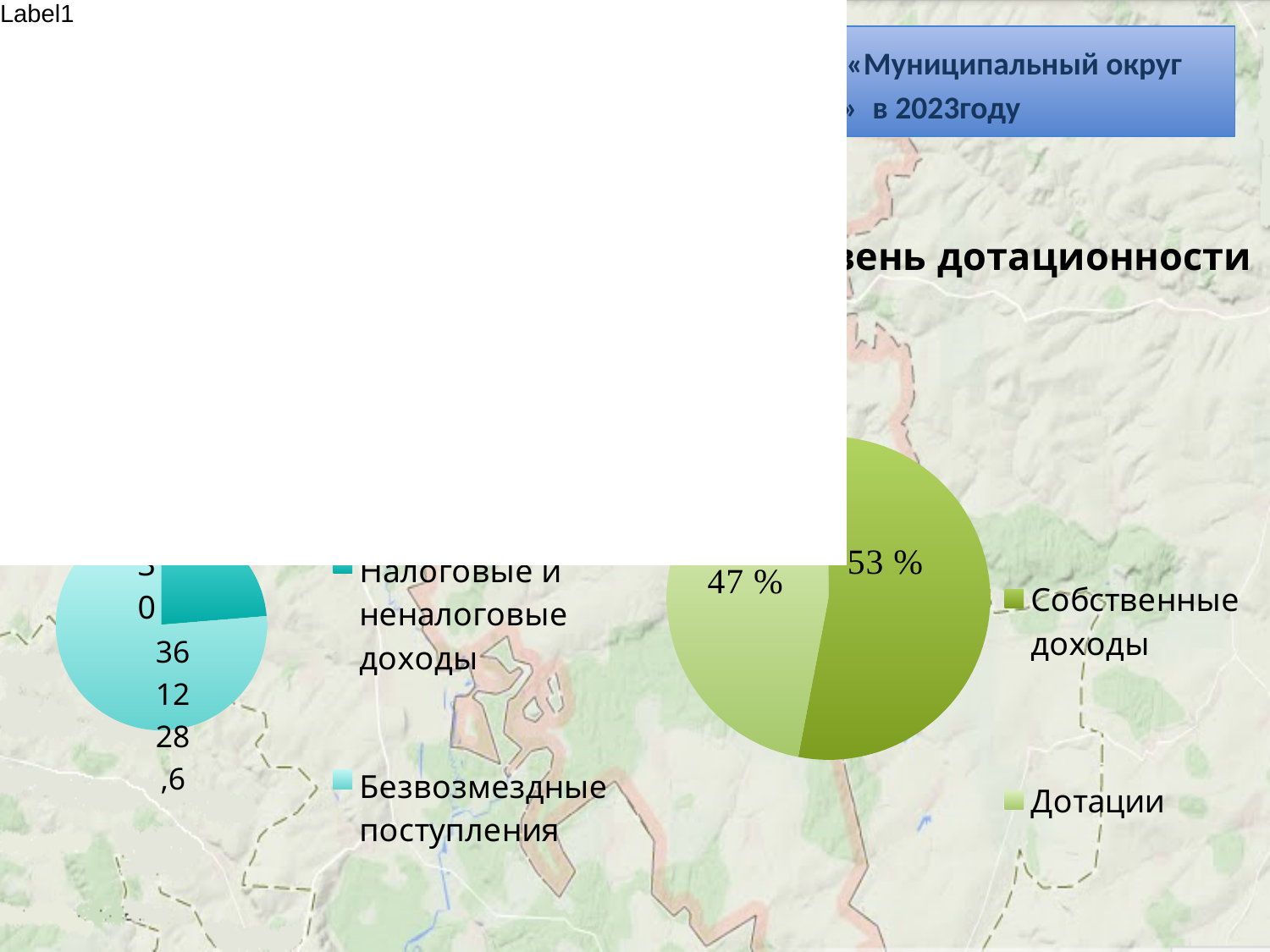
On the right pie chart, which category has the smallest share? Дотации On the right pie chart, what is the difference between the shares of Собственные доходы and Дотации? 6 % On the right pie chart, is the share for Дотации greater or less than 50%? less What kind of chart is the chart on the right of the slide? Pie chart On the right pie chart, what share is shown for Собственные доходы? 53 % On the right pie chart, which is larger: Собственные доходы or Дотации? Собственные доходы On the right pie chart, which category has the largest share? Собственные доходы On the right pie chart, what share is shown for Дотации? 47 % How many entries does the legend of the left pie chart list? 2 On the left pie chart, which slice is larger: Налоговые и неналоговые доходы or Безвозмездные поступления? Безвозмездные поступления What kind of chart is the chart on the left of the slide? Pie chart How many categories does the right pie chart show? 2